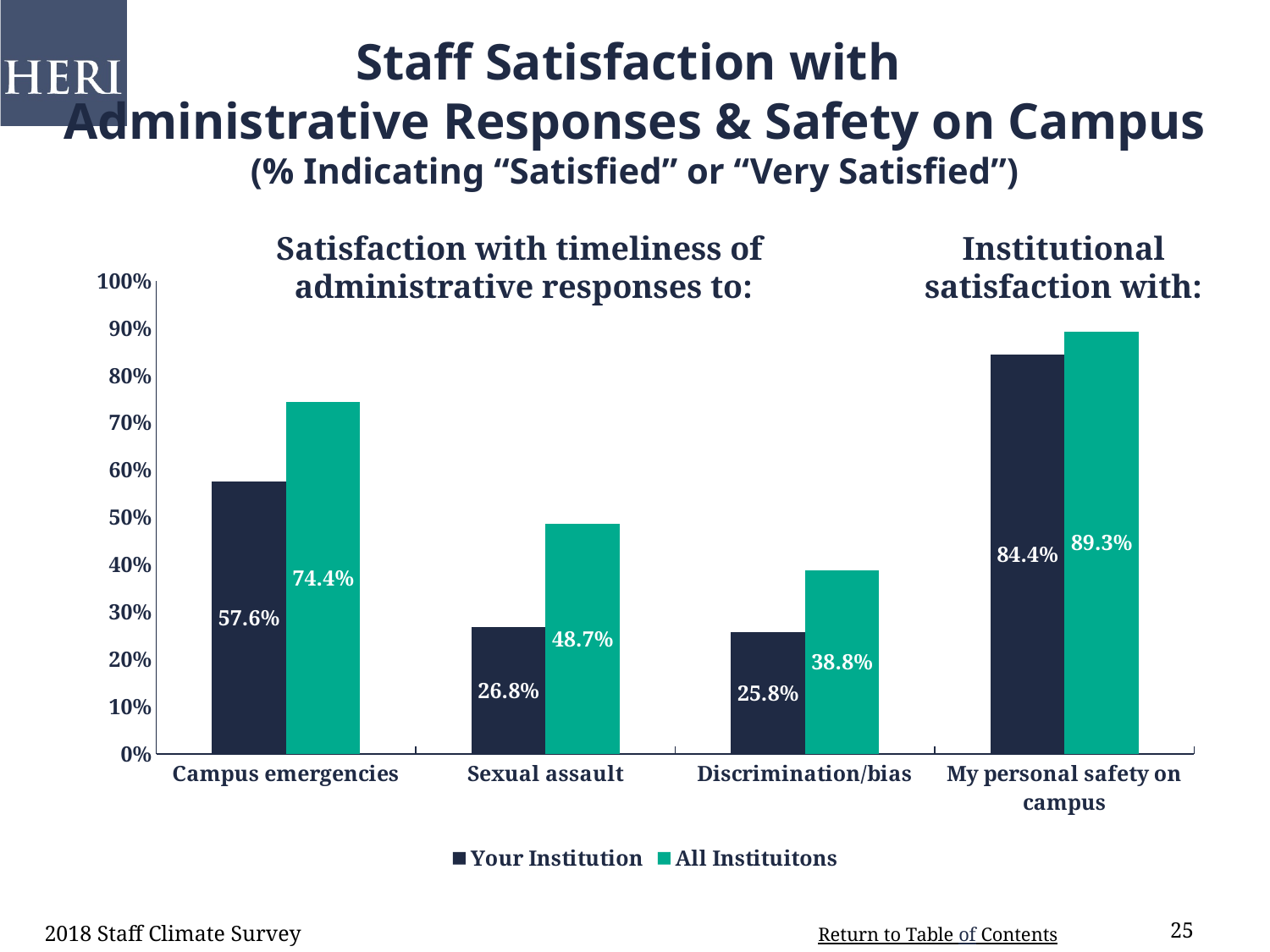
Which category has the lowest value for All Instituitons? Discrimination/bias What is the value for All Instituitons for My personal safety on campus? 89.3% What is the value for Your Institution for Campus emergencies? 57.6% Which category has the highest value for Your Institution? My personal safety on campus What is the value for Your Institution for Discrimination/bias? 25.8% How many series does the legend list? 2 What colour are the bars for All Instituitons? Teal/green Which is larger for Sexual assault: Your Institution or All Instituitons? All Instituitons What is the value for All Instituitons for Sexual assault? 48.7% How many categories are shown on the x axis? 4 What kind of chart is shown on the slide? Bar chart What is the difference between All Instituitons and Your Institution for Campus emergencies? 16.8%